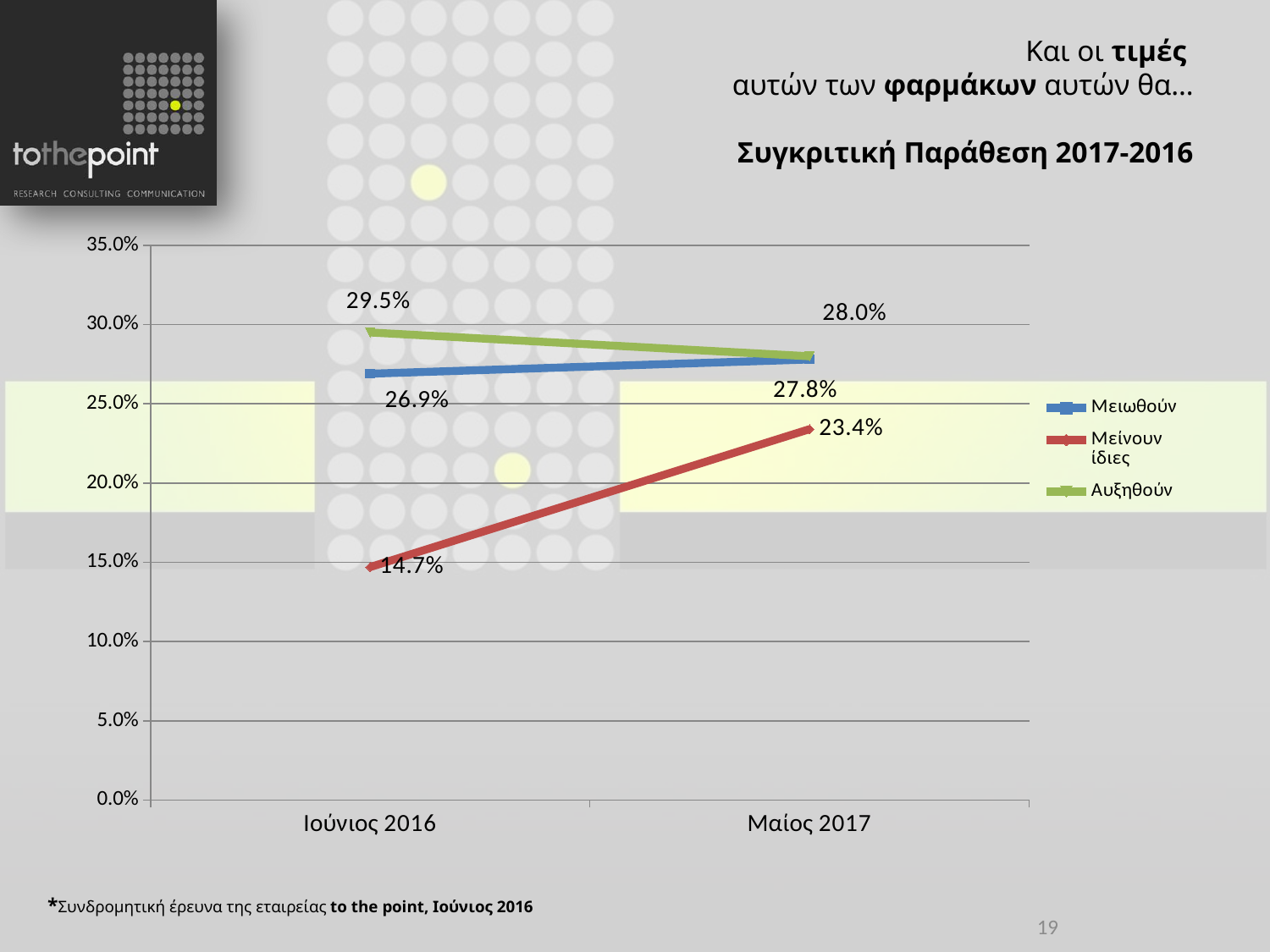
What kind of chart is shown on the slide? line chart What is the value for Μειωθούν in Ιούνιος 2016? 26.9% How many categories are shown on the x axis? 2 Which series has the lowest value in Ιούνιος 2016? Μείνουν ίδιες Does the Αυξηθούν series rise or fall from Ιούνιος 2016 to Μαΐος 2017? fall Is the value for Μείνουν ίδιες in Ιούνιος 2016 greater or less than 20.0%? less What colour is the line for Μείνουν ίδιες? red How many series does the legend list? 3 Which series has the highest value in Ιούνιος 2016? Αυξηθούν What is the value for Αυξηθούν in Ιούνιος 2016? 29.5% What is the value for Μείνουν ίδιες in Μαΐος 2017? 23.4% What is the difference between the Μείνουν ίδιες values in Μαΐος 2017 and Ιούνιος 2016? 8.7%